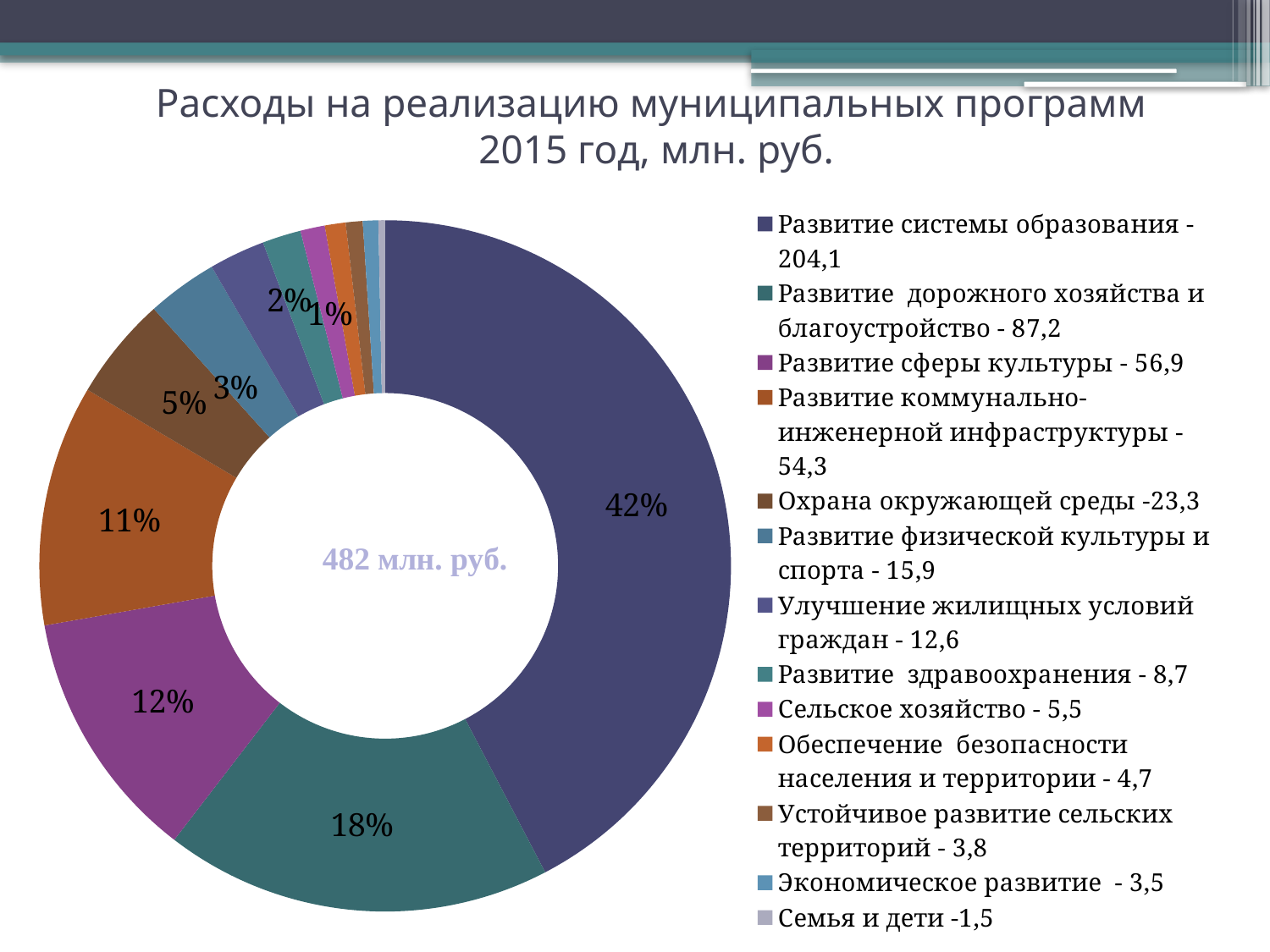
Which category has the smallest value in the chart? Семья и дети What total is printed in the centre of the doughnut chart? 482 млн. руб. What is the value for 'Развитие сферы культуры' according to the legend? 56,9 What kind of chart is shown on the slide? pie (doughnut) chart What share of the chart does 'Развитие системы образования' take? 42% What percentage is shown for 'Развитие дорожного хозяйства и благоустройство'? 18% How many categories does the legend of the chart list? 13 What percentage label is shown for 'Охрана окружающей среды'? 5% Which is larger: 'Охрана окружающей среды' or 'Развитие физической культуры и спорта'? Охрана окружающей среды Which category has the largest share of expenditures in the chart? Развитие системы образования What is the difference between the values for 'Развитие системы образования' (204,1) and 'Развитие дорожного хозяйства и благоустройство' (87,2)? 116,9 What is the value for 'Экономическое развитие' in the legend? 3,5